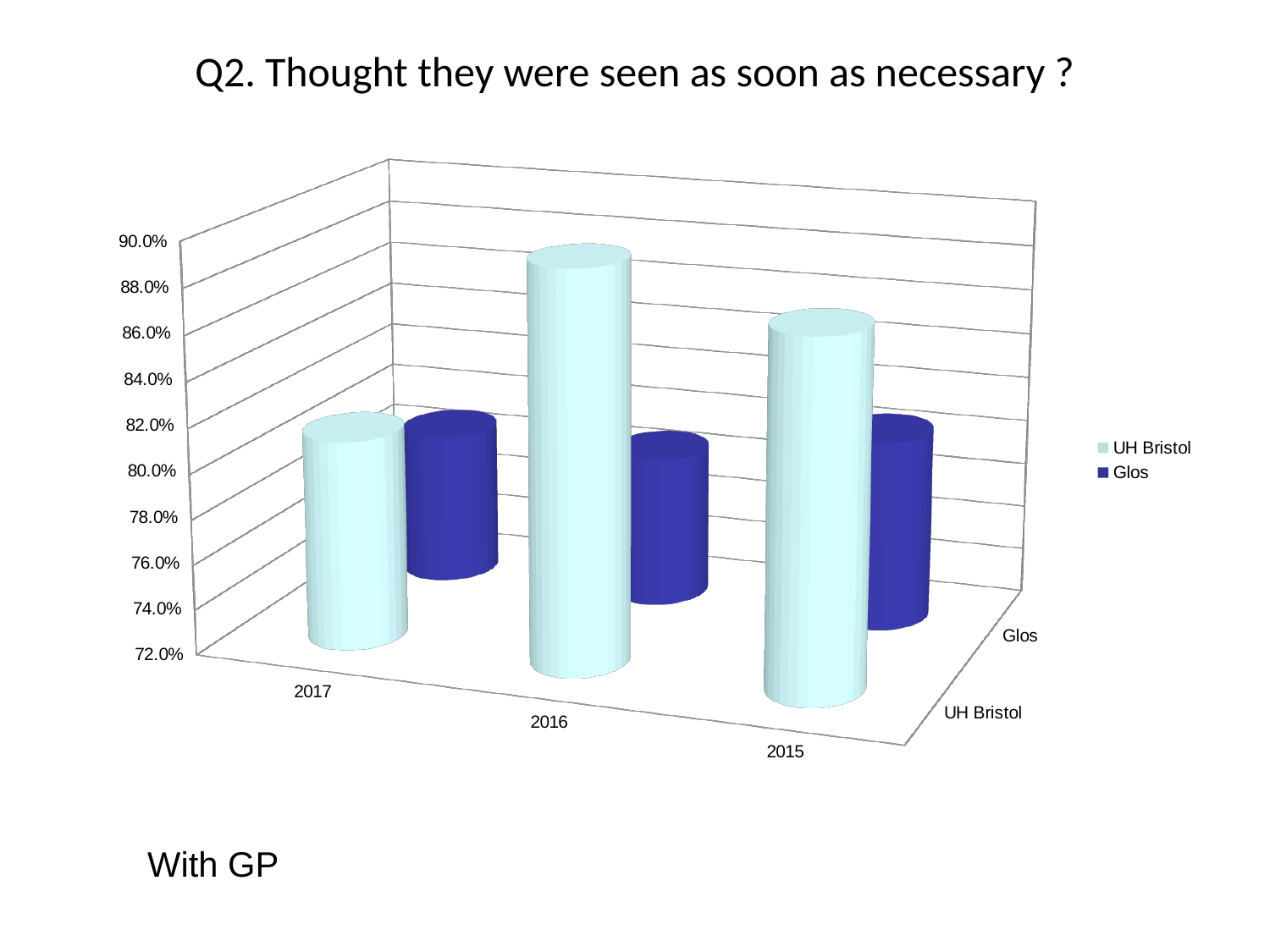
Which year has the highest value for UH Bristol? 2016 How many series does the legend list? 2 How many years are shown along the x axis? 3 In 2016, which is larger: UH Bristol or Glos? UH Bristol In 2015, which is larger: UH Bristol or Glos? UH Bristol Is the value for UH Bristol in 2017 greater or less than 86.0%? less Which series has the tallest bar on the chart? UH Bristol What is the title of the chart? Q2. Thought they were seen as soon as necessary ? Is the value for UH Bristol in 2016 greater or less than 84.0%? greater Does the UH Bristol value rise or fall from 2017 to 2016? rises Which year has the lowest value for UH Bristol? 2017 What kind of chart is shown on the slide? bar chart